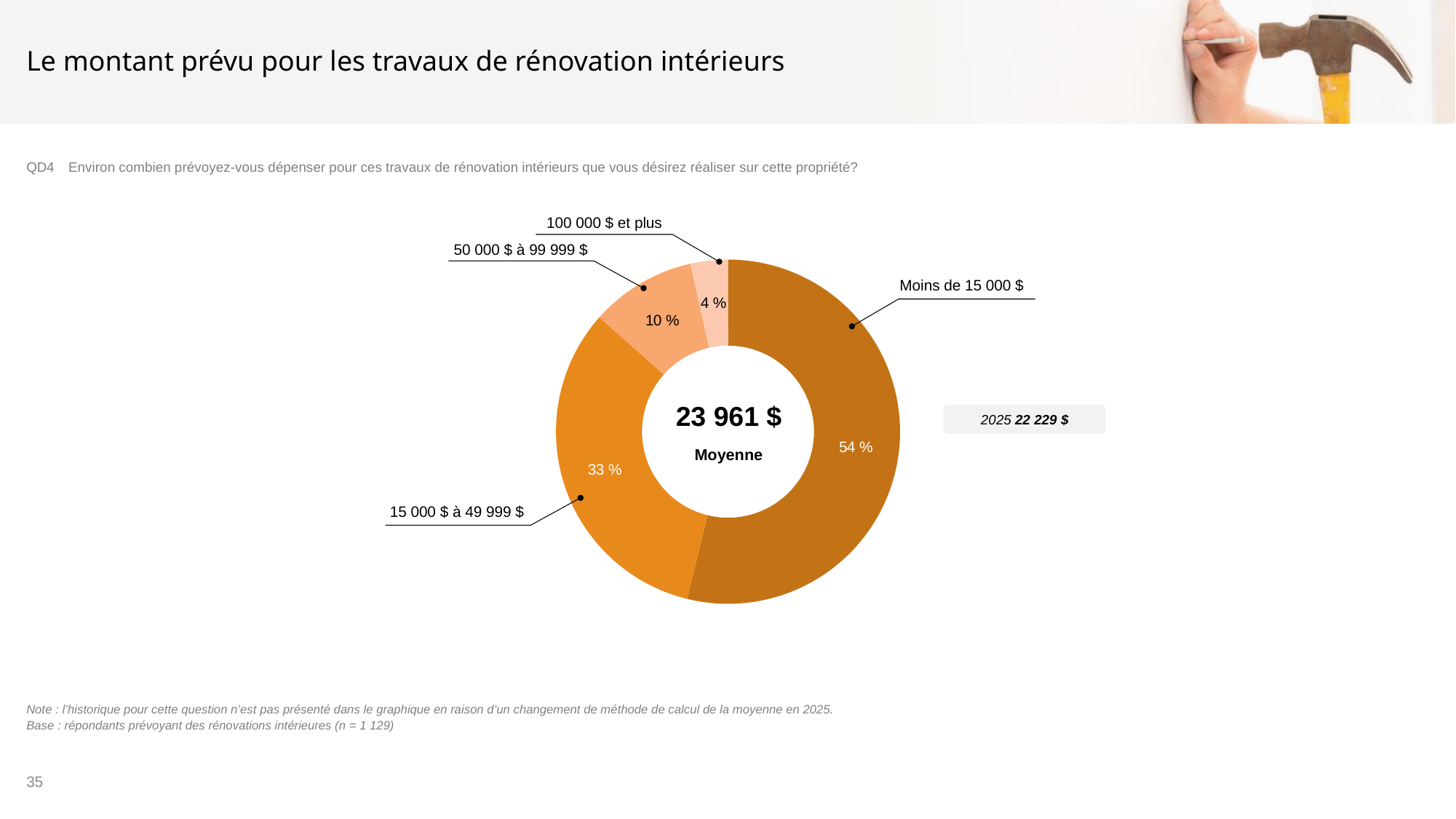
How many spending categories are shown in the chart? 4 What share of respondents plan to spend 50 000 $ à 99 999 $? 10 % Which spending category has the smallest share of the pie? 100 000 $ et plus What is the difference in percentage points between the 'Moins de 15 000 $' and '15 000 $ à 49 999 $' slices? 21 Which spending category has the largest share of the pie? Moins de 15 000 $ What kind of chart is shown on the slide? Pie chart (donut) What share of respondents plan to spend 15 000 $ à 49 999 $? 33 % Which slice is larger: '50 000 $ à 99 999 $' or '100 000 $ et plus'? 50 000 $ à 99 999 $ What share of respondents plan to spend less than 15 000 $ (Moins de 15 000 $)? 54 % What was the average amount shown for 2025? 22 229 $ What share of respondents plan to spend 100 000 $ et plus? 4 % What average amount (Moyenne) is shown in the centre of the chart? 23 961 $